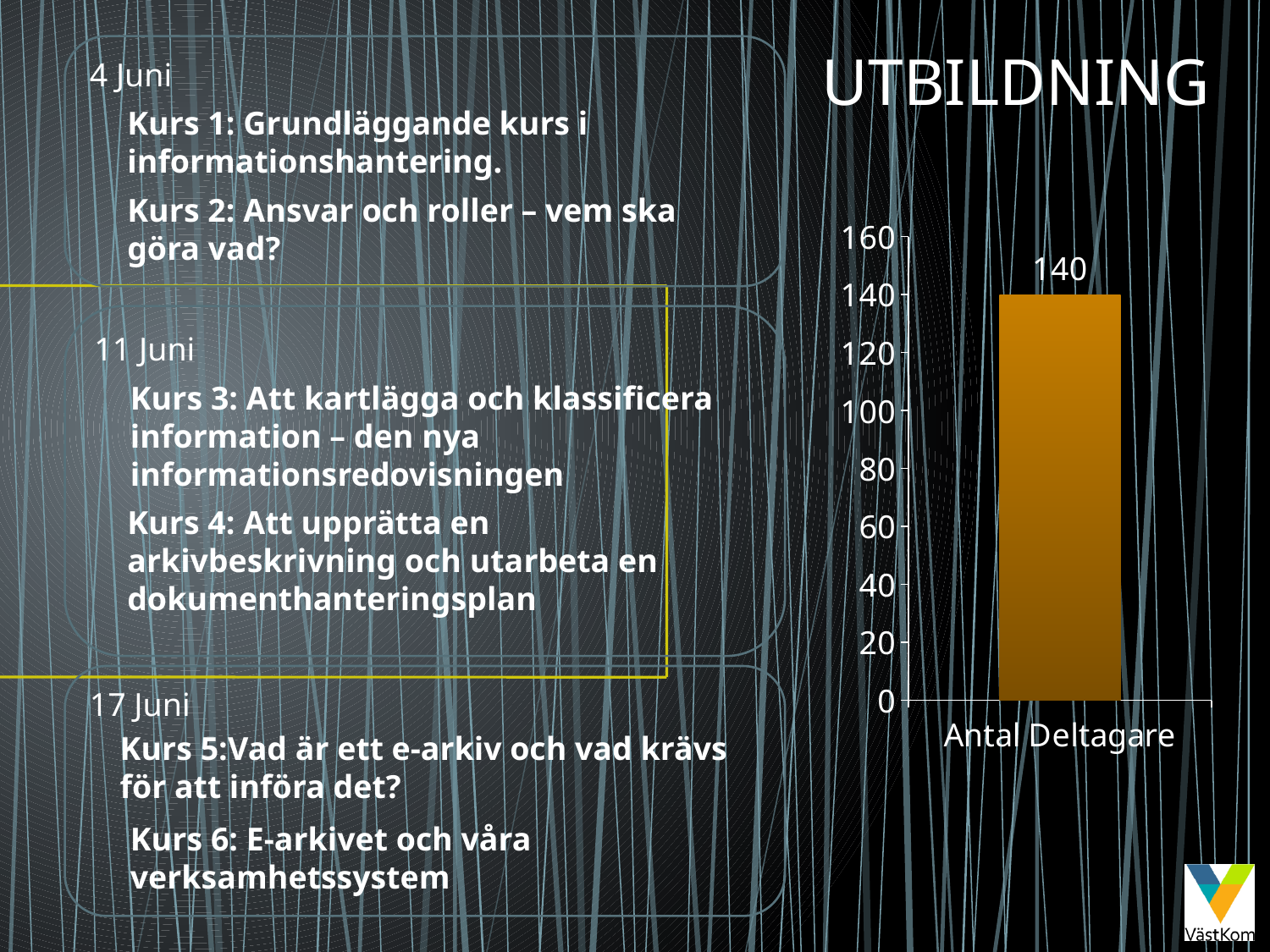
Is the value for Antal Deltagare greater or less than 160? less What is the value of the bar for Antal Deltagare? 140 Is the value for Antal Deltagare greater or less than 100? greater How many bars does the chart show? 1 What kind of chart is shown on the slide? bar chart What is the category label shown under the bar? Antal Deltagare What is the highest value shown on the chart's vertical axis? 160